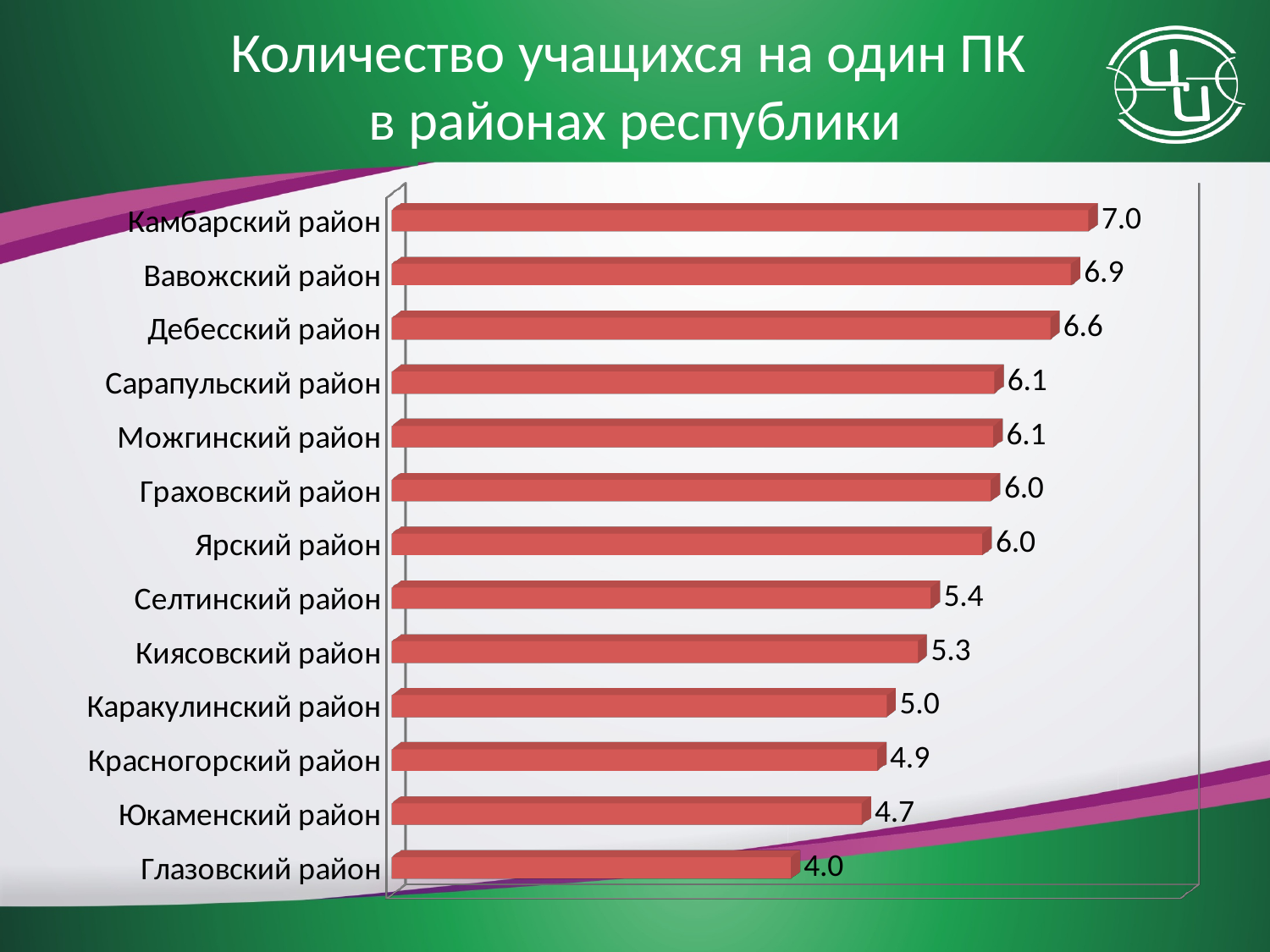
Which district has the lowest value? Глазовский район What is the title of the slide? Количество учащихся на один ПК в районах республики What is the value for Селтинский район? 5.4 What is the value for Глазовский район? 4.0 Which is larger, the value for Вавожский район or the value for Юкаменский район? Вавожский район What is the value for Красногорский район? 4.9 How many districts are shown in the chart? 13 What is the difference between the values for Дебесский район and Киясовский район? 1.3 What is the value for Камбарский район? 7.0 What is the difference between the values for Камбарский район and Глазовский район? 3.0 Which district has the highest value? Камбарский район What kind of chart is shown on the slide? bar chart